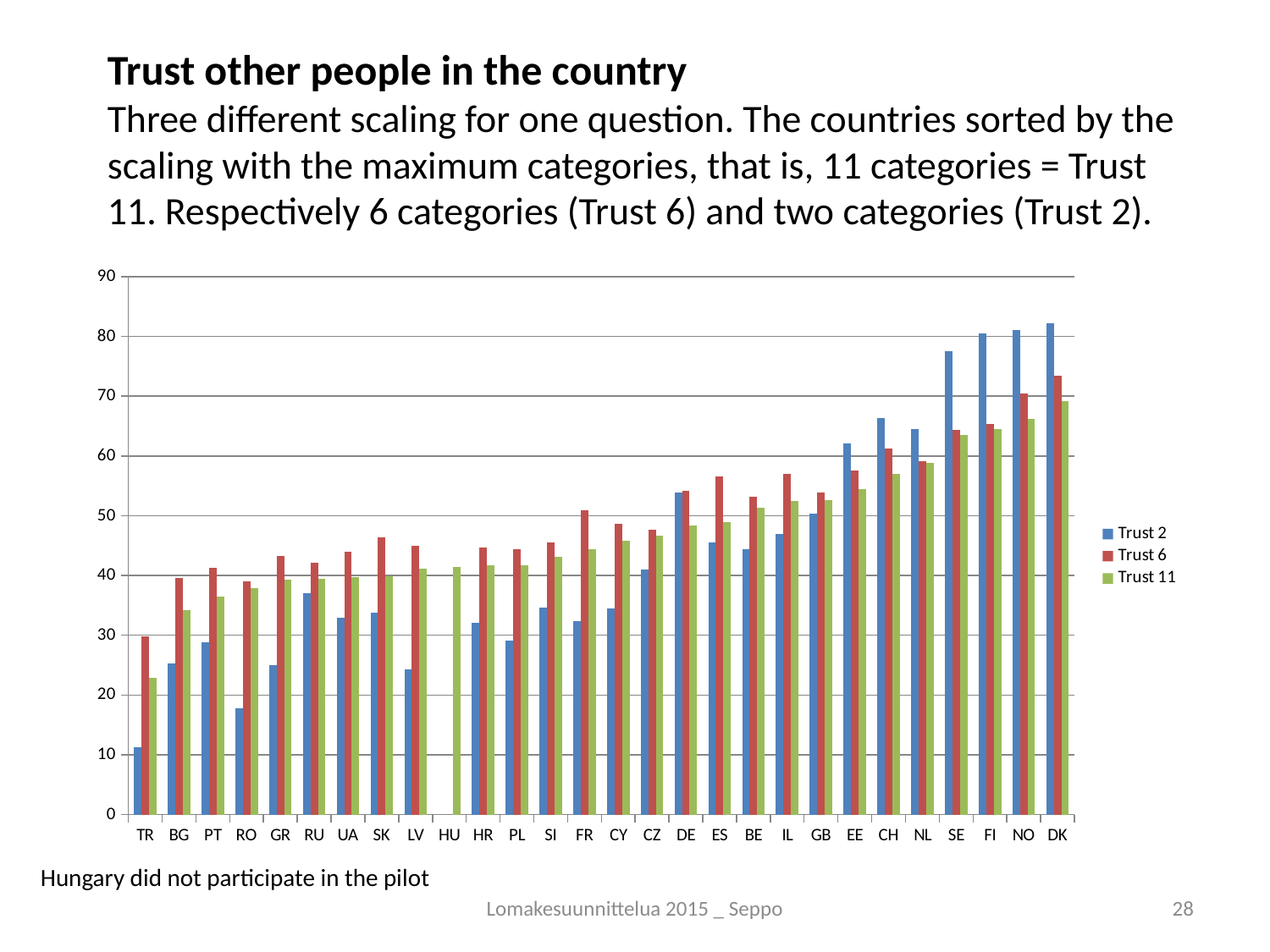
Is the Trust 6 value for IL greater or less than 50? greater Which country has the highest Trust 2 value? DK How many countries are shown along the x axis? 28 Is the Trust 2 value for SE greater or less than 70? greater Which country has the lowest Trust 2 value? TR Is the Trust 2 value for RO greater or less than 20? less What kind of chart is shown on the slide? bar chart Which country has the highest Trust 11 value? DK Which is larger, the Trust 2 value for DE or the Trust 2 value for ES? DE Which country has only a Trust 11 bar and no Trust 2 or Trust 6 bars? HU Do the Trust 11 values generally rise or fall from left to right along the x axis? rise How many series does the legend list? 3